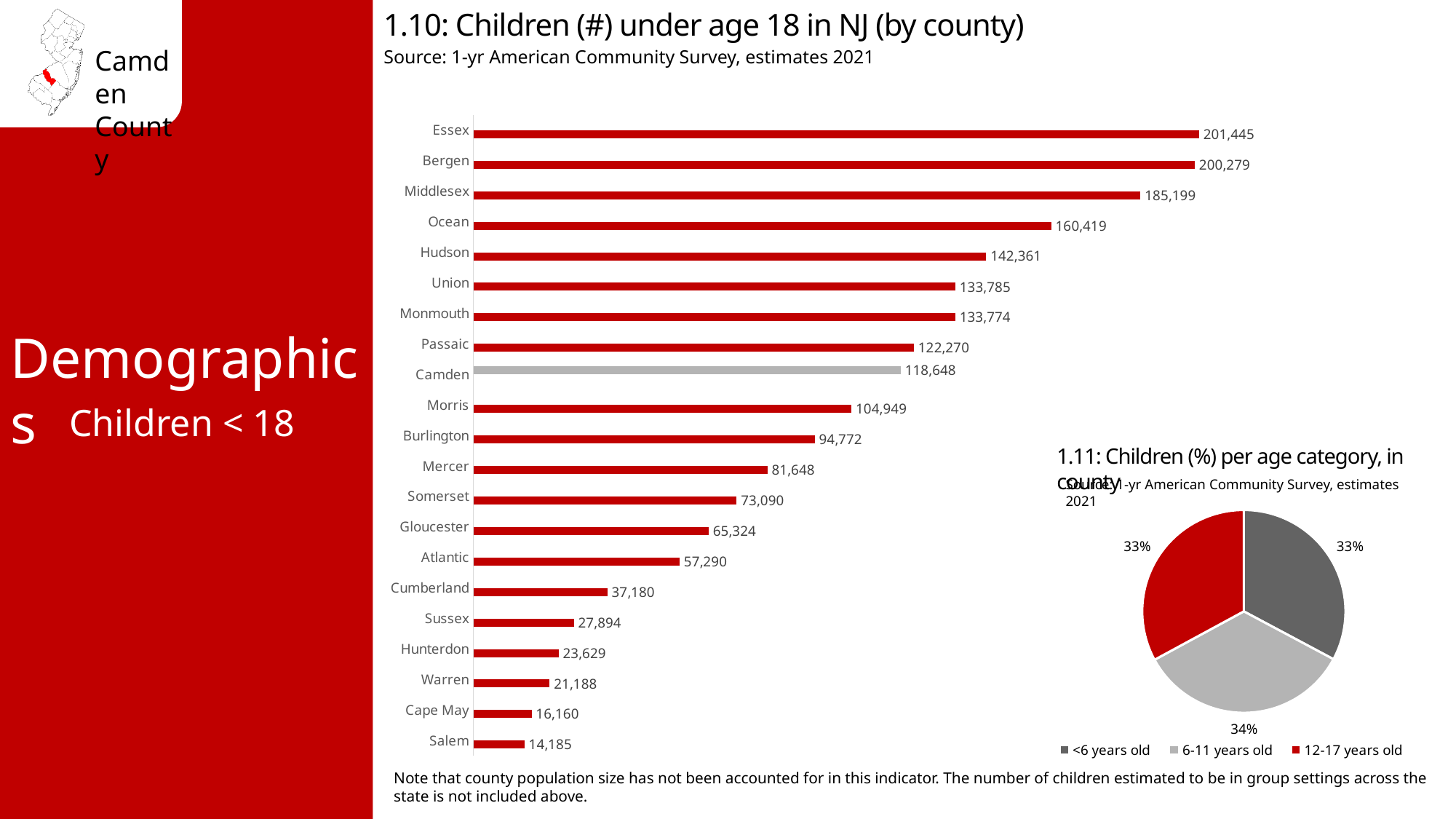
In chart 1.10, how many counties are shown? 21 What kind of chart is chart 1.11? Pie chart In chart 1.10, which county has the highest number of children under 18? Essex In chart 1.10, which is larger, the value for Passaic or the value for Camden? Passaic In chart 1.10, what is the difference between the values for Essex and Bergen? 1,166 In chart 1.10, which county has the lowest number of children under 18? Salem In chart 1.10, what is the value for Ocean? 160,419 In chart 1.11, how many age categories does the legend list? 3 What kind of chart is chart 1.10? Bar chart In chart 1.10, which county's bar is shown in grey instead of red? Camden In chart 1.10 (Children under age 18 in NJ by county), what is the value for Camden? 118,648 In chart 1.11 (Children (%) per age category, in county), what share of children are 6-11 years old? 34%